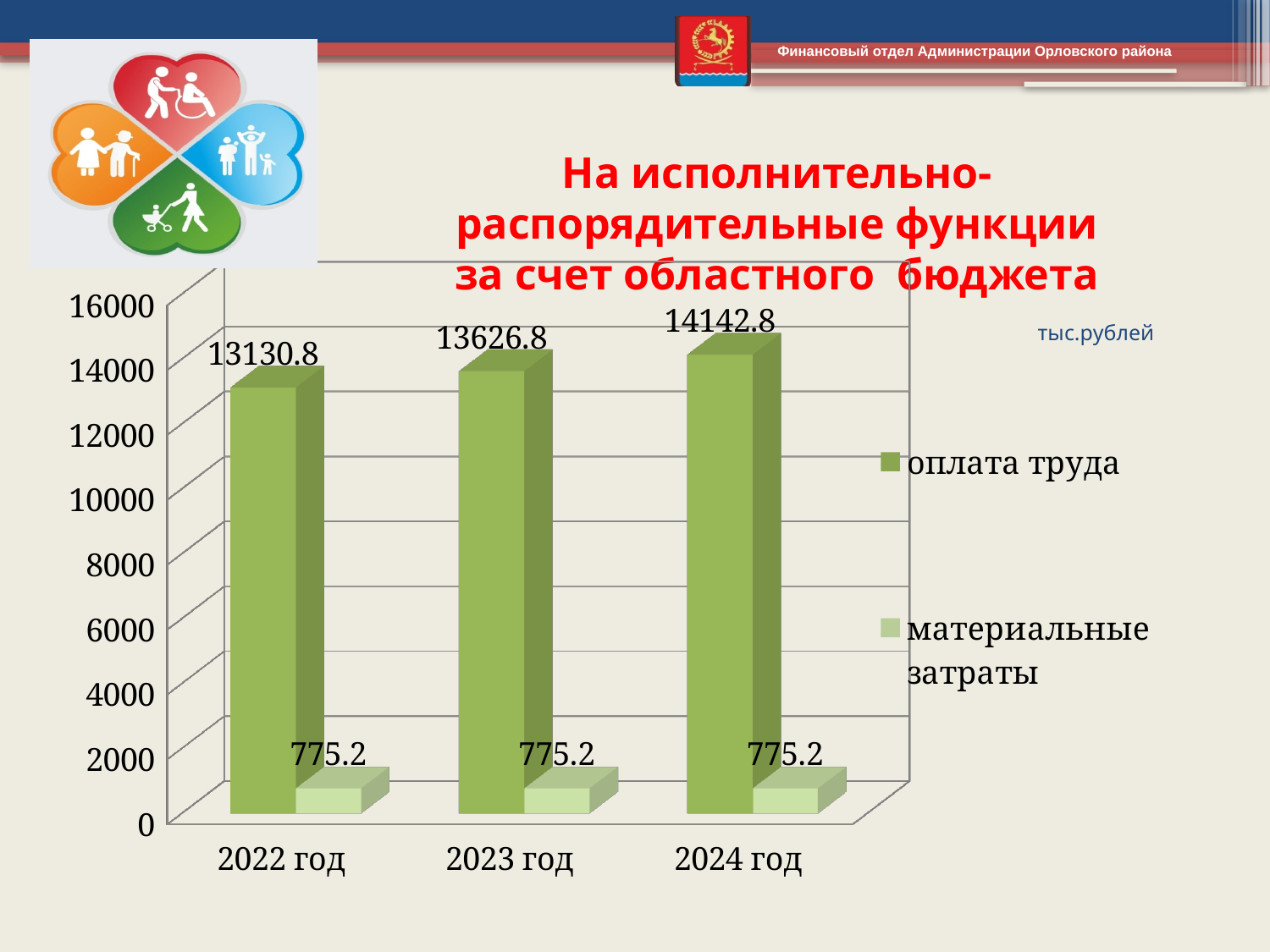
What is the difference between оплата труда in 2023 год and 2022 год? 496 Is the value of оплата труда for 2023 год greater or less than 12000? greater Which year has the highest value for оплата труда? 2024 год How many series does the legend list? 2 How many years are shown on the x axis? 3 What is the value of материальные затраты for 2023 год? 775.2 What is the difference between оплата труда in 2024 год and 2023 год? 516 What is the value of оплата труда for 2024 год? 14142.8 What is the value of оплата труда for 2022 год? 13130.8 Which is larger: оплата труда in 2022 год or материальные затраты in 2022 год? оплата труда in 2022 год Which year has the lowest value for оплата труда? 2022 год What kind of chart is shown on the slide? bar chart